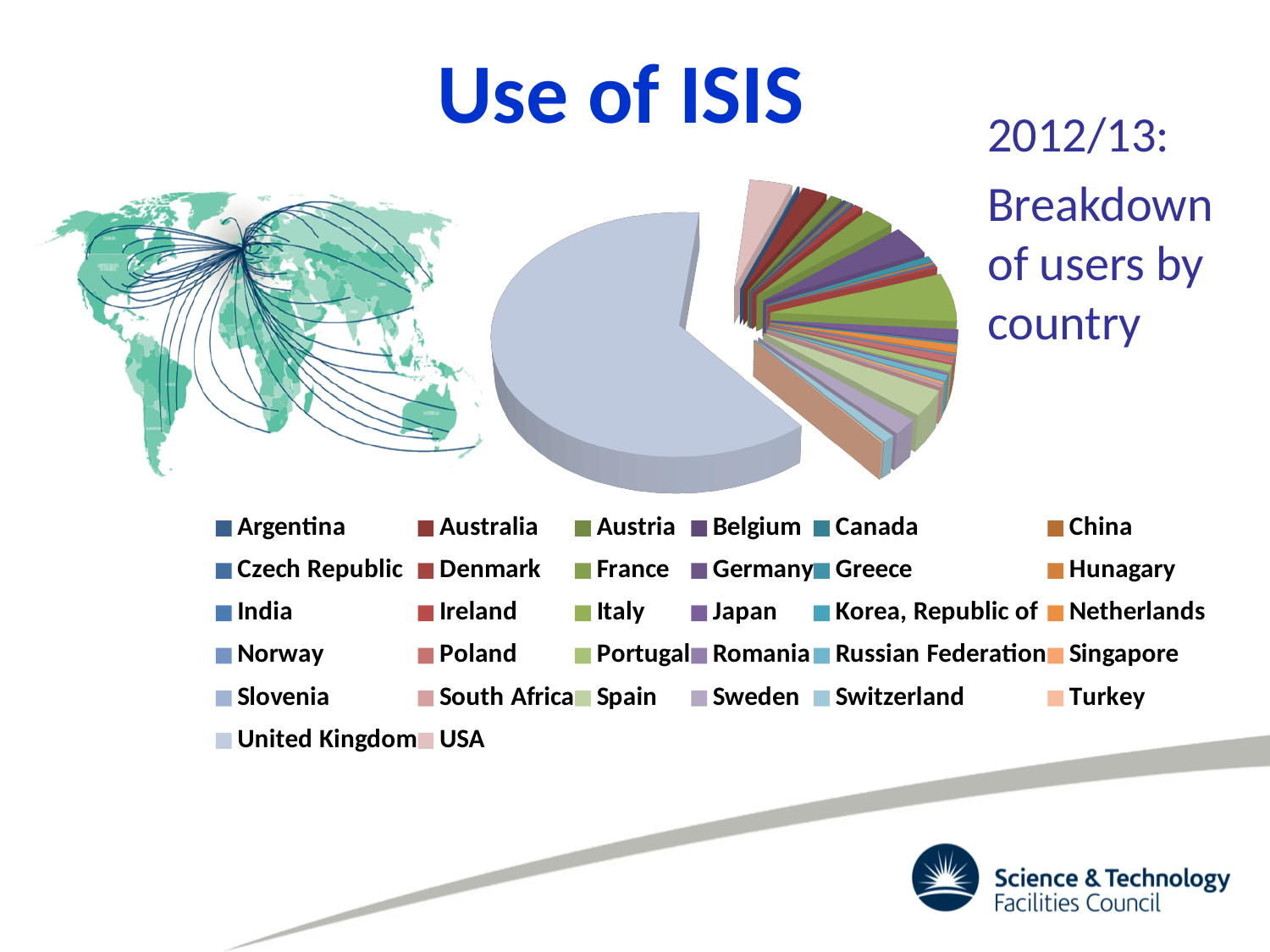
Which country is listed last in the pie chart's legend? USA Which is larger in the pie chart, the slice for the United Kingdom or the slice for USA? United Kingdom Which country is listed first in the pie chart's legend? Argentina Which country has the largest slice in the pie chart? United Kingdom What kind of chart is shown on the slide? pie chart What does the pie chart show, according to the text beside it? 2012/13: Breakdown of users by country Does the United Kingdom slice take up more or less than half of the pie chart? more How many countries are listed in the legend of the pie chart? 32